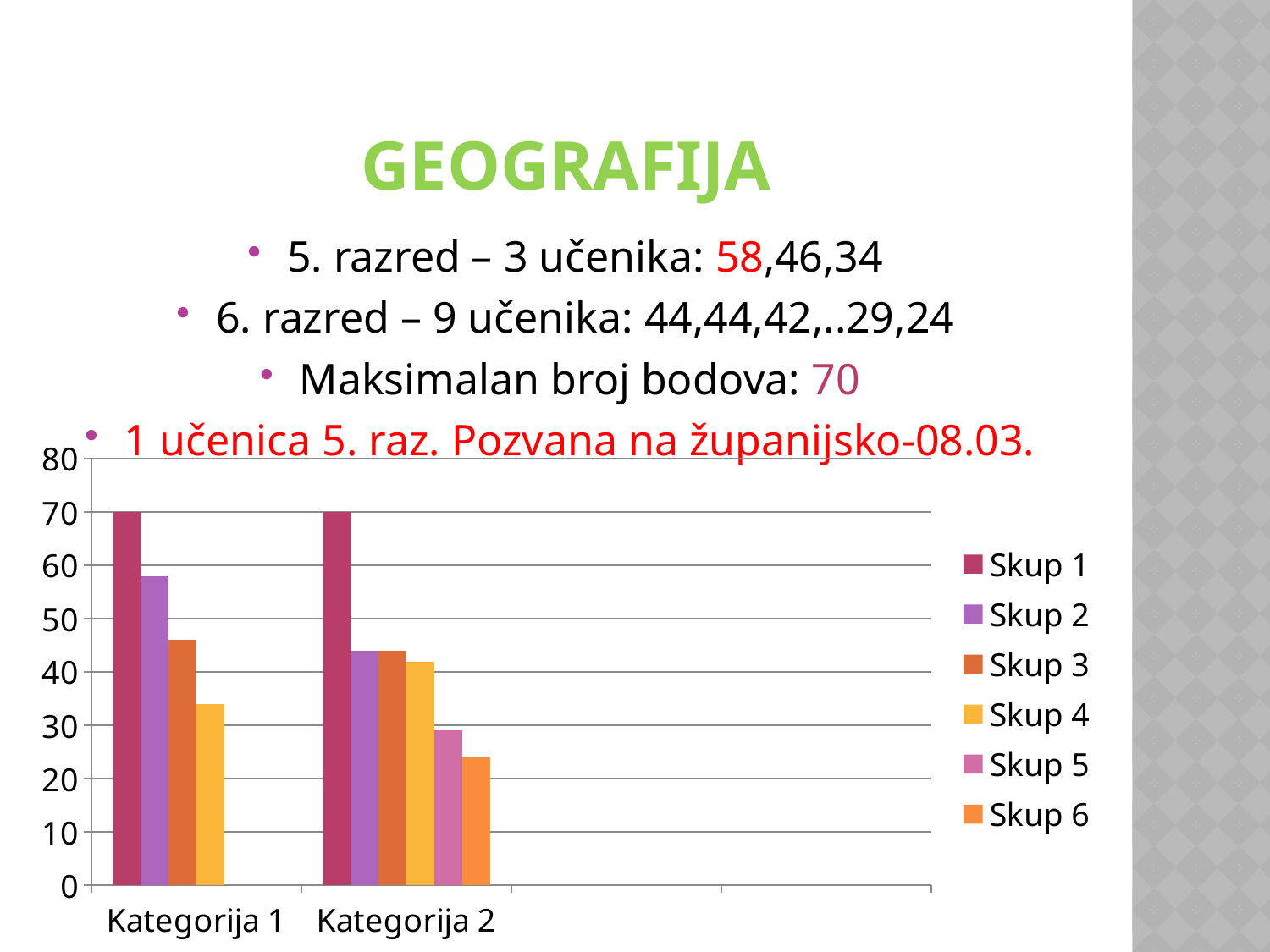
Which series has the highest value in Kategorija 1? Skup 1 How many categories are shown on the x axis of the chart? 2 What is the first entry listed in the chart legend? Skup 1 Which series has the lowest value in Kategorija 2? Skup 6 How many series does the chart legend list? 6 Which series has the lowest value in Kategorija 1? Skup 4 What kind of chart is shown on the slide? bar chart Which is larger: Skup 2 in Kategorija 1 or Skup 2 in Kategorija 2? Skup 2 in Kategorija 1 What is the value of Skup 1 for Kategorija 1? 70 Is the value for Skup 2 in Kategorija 1 greater or less than 50? greater What is the value of Skup 1 for Kategorija 2? 70